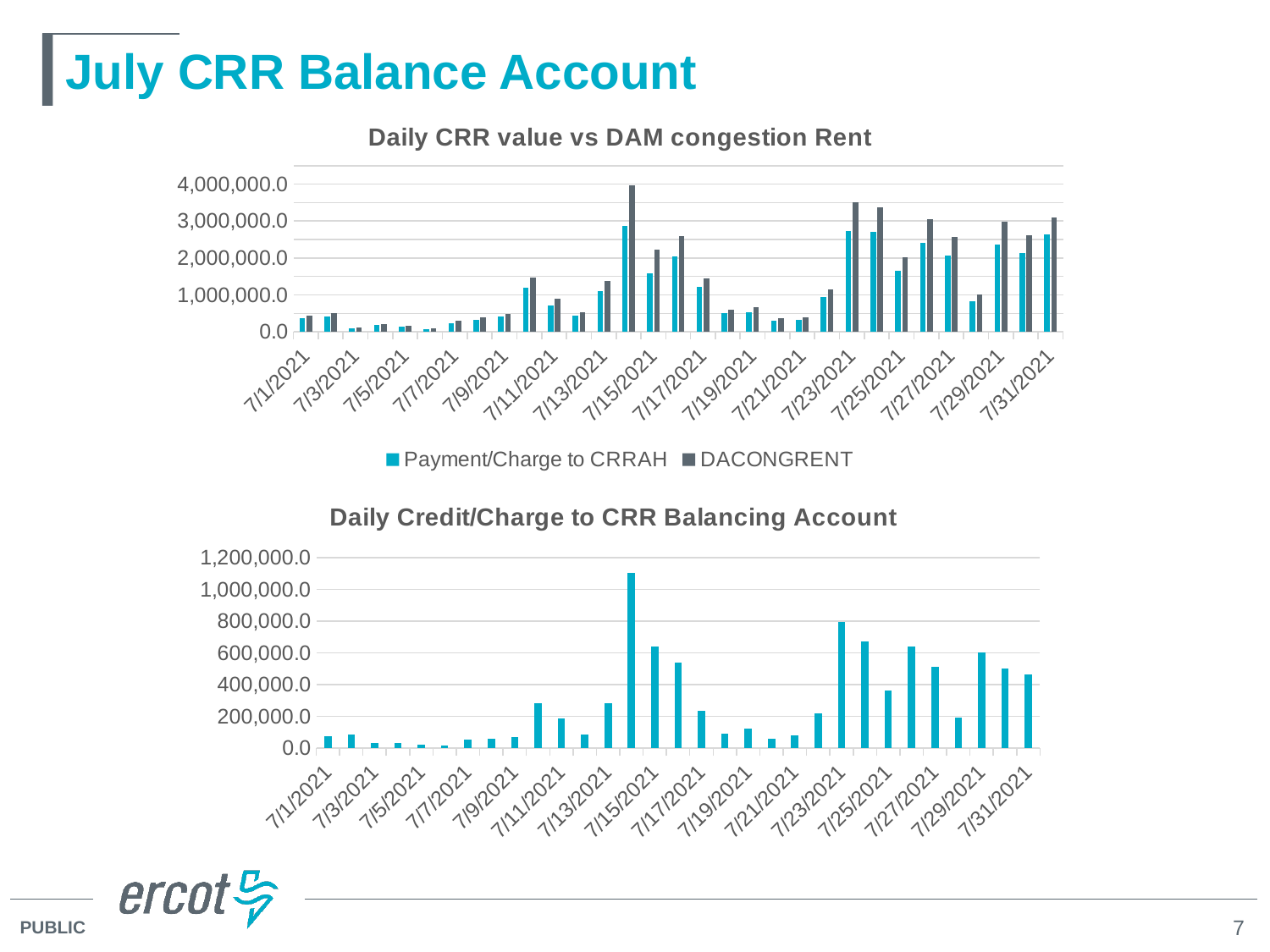
In the bottom chart, are the values in the first week of July generally higher or lower than those in the last week of July? lower In the bottom chart, is the value for 7/1/2021 greater or less than 200,000.0? less In the bottom chart, is the tallest bar greater or less than 1,000,000.0? greater What is the title of the bottom chart? Daily Credit/Charge to CRR Balancing Account In the bottom chart, is the value for 7/31/2021 greater or less than 600,000.0? less What are the two series named in the legend of the top chart? Payment/Charge to CRRAH and DACONGRENT What kind of chart is the top chart, 'Daily CRR value vs DAM congestion Rent'? Bar chart How many date labels are shown on the x axis of the bottom chart? 16 In the top chart, which series has the taller bar at 7/23/2021? DACONGRENT How many series does the legend of the top chart list? 2